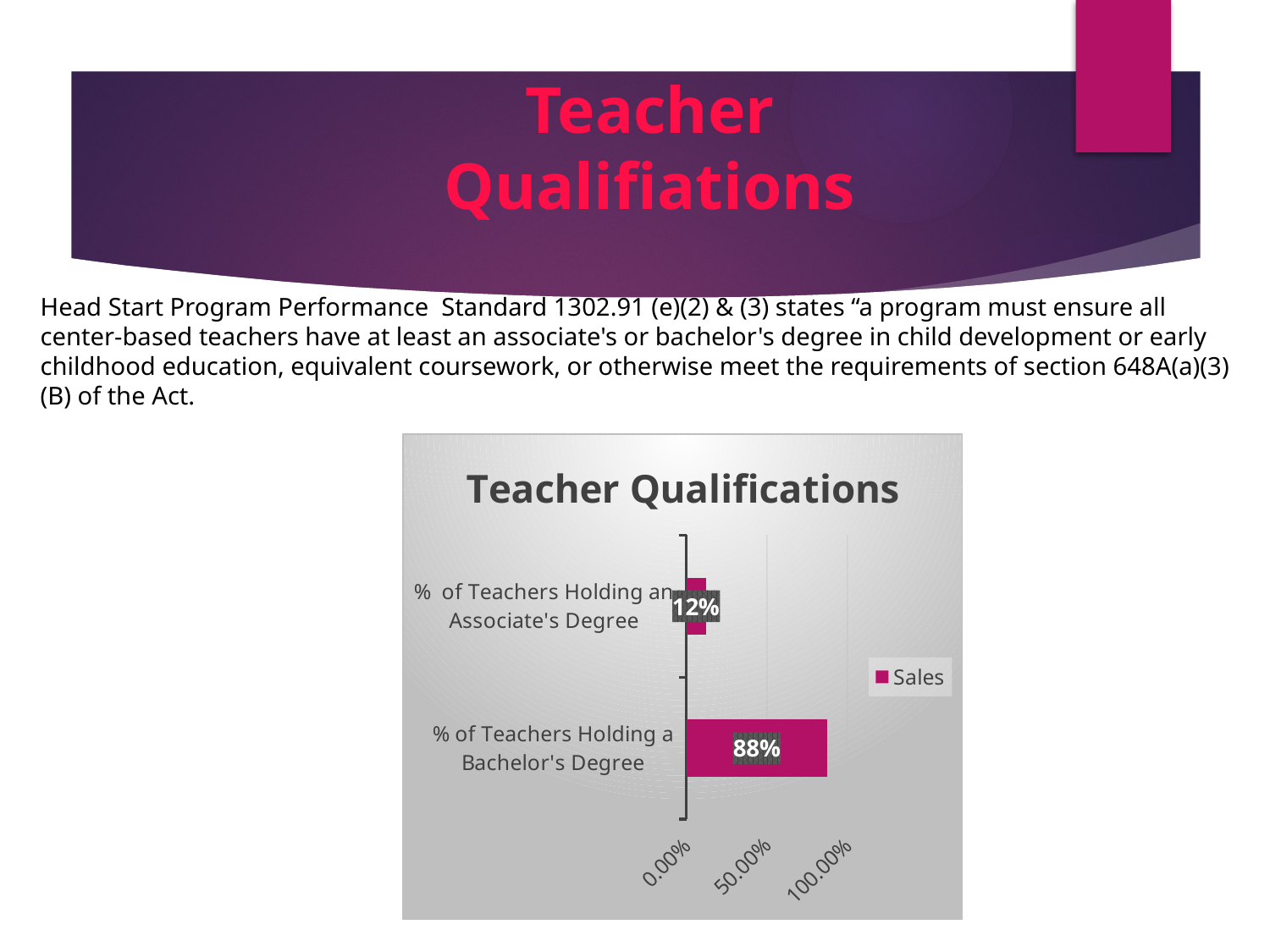
Which category has the lowest value in the chart? % of Teachers Holding an Associate's Degree Is the value for % of Teachers Holding a Bachelor's Degree greater or less than 50.00%? greater Is the value for % of Teachers Holding an Associate's Degree greater or less than 50.00%? less What is the difference between the percentage of teachers holding a Bachelor's Degree and those holding an Associate's Degree? 76% How many categories are shown in the chart? 2 What kind of chart is shown on the slide? Bar chart What percentage of teachers hold an Associate's Degree according to the chart? 12% How many series does the chart legend list? 1 Which is larger: the percentage of teachers holding a Bachelor's Degree or the percentage holding an Associate's Degree? % of Teachers Holding a Bachelor's Degree What is the title of the chart? Teacher Qualifications What percentage of teachers hold a Bachelor's Degree according to the chart? 88% Which category has the highest value in the chart? % of Teachers Holding a Bachelor's Degree